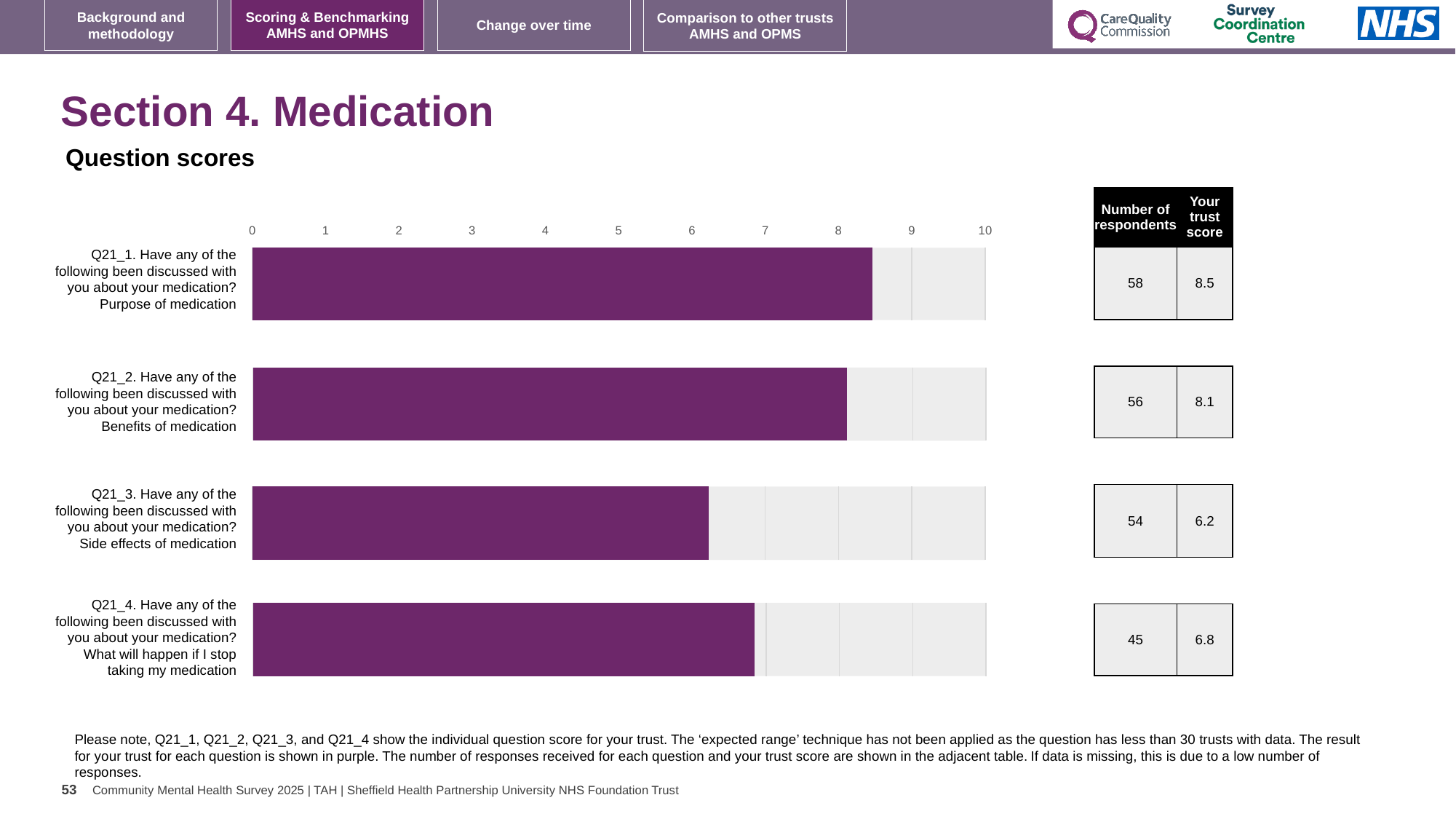
What is the difference between the trust scores for Q21_1 (Purpose of medication) and Q21_3 (Side effects of medication)? 2.3 Which question has the lowest trust score? Q21_3. Side effects of medication Which has the higher trust score, Q21_2 (Benefits of medication) or Q21_4 (What will happen if I stop taking my medication)? Q21_2. Benefits of medication Which question has the highest trust score? Q21_1. Purpose of medication Is the trust score for Q21_2 (Benefits of medication) greater or less than 8? greater What is the trust score for Q21_3 (Side effects of medication)? 6.2 What is the trust score for Q21_1 (Purpose of medication)? 8.5 How many respondents answered Q21_4 (What will happen if I stop taking my medication)? 45 How many questions are plotted in the chart? 4 What colour are the bars showing the trust's results? Purple What kind of chart is shown on the slide? Bar chart What is the maximum value shown on the chart's axis? 10